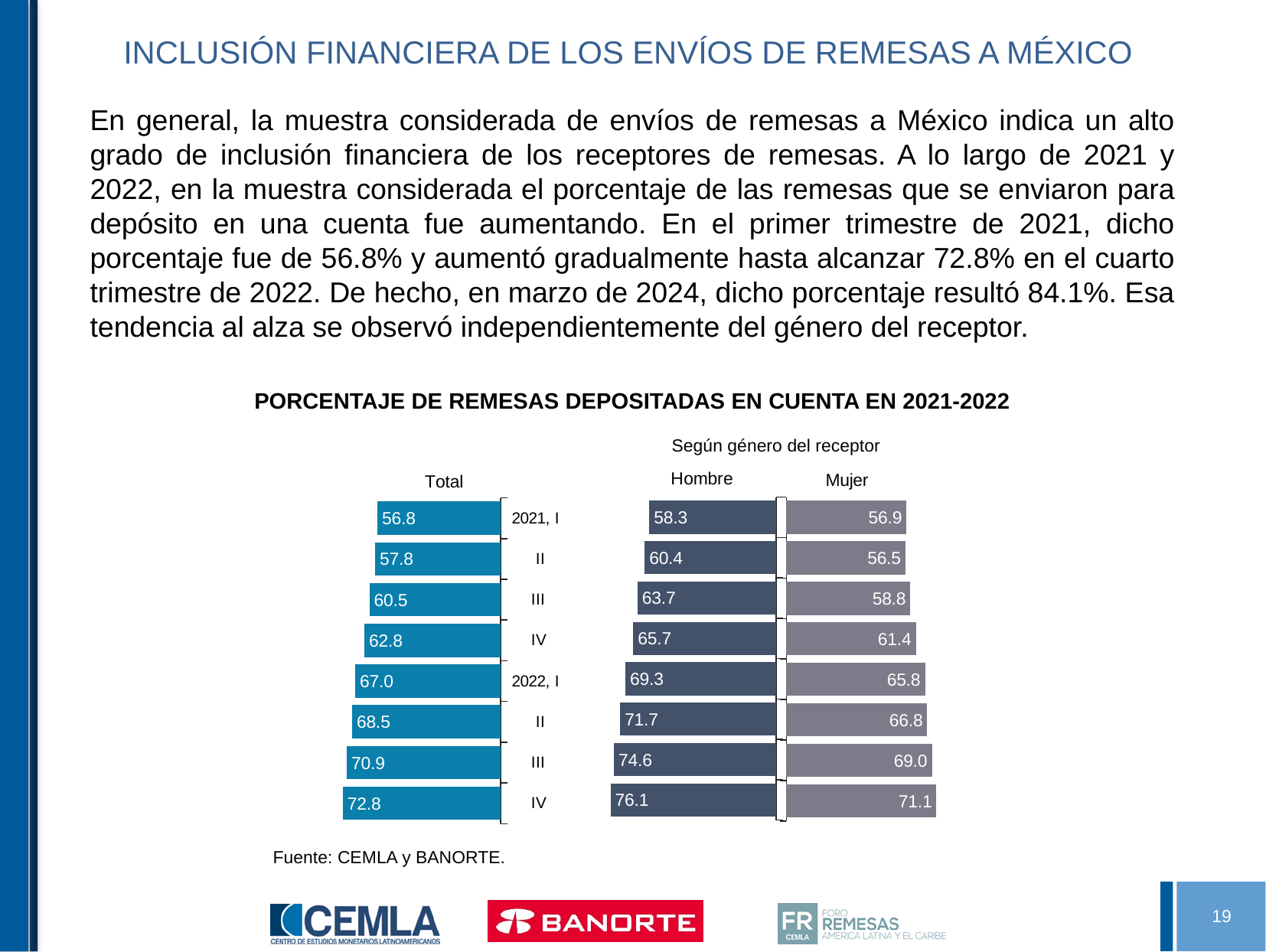
What kind of chart is shown on the slide? Bar chart What is the difference between the Total values in 2022, IV and 2021, I? 16.0 In 2022, I, which is larger: the Hombre value or the Mujer value? Hombre What is the value for Mujer in 2021, III? 58.8 Which quarter has the lowest Mujer value? 2021, II How many series does the chart show (Total, Hombre, Mujer)? 3 How many quarters are shown in the chart? 8 What is the value for Hombre in 2022, IV? 76.1 Do the Total values rise or fall from 2021, I to 2022, IV? Rise Which quarter has the highest Total value? 2022, IV What is the Total percentage of remittances deposited in an account in 2021, I? 56.8 What is the difference between the Hombre and Mujer values in 2022, IV? 5.0